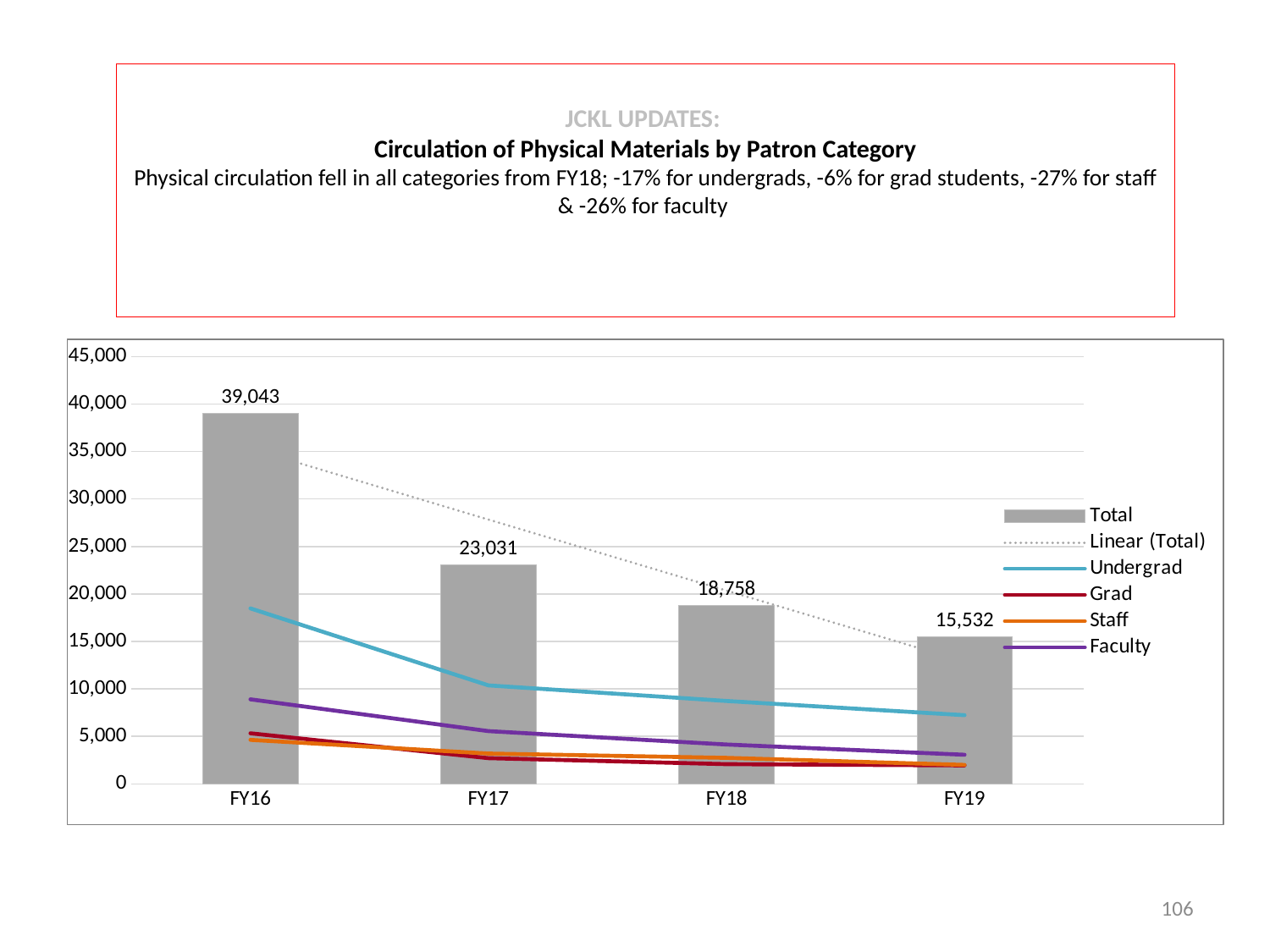
What is the Total circulation value for FY16? 39,043 What is the difference between the Total circulation in FY16 and FY17? 16,012 Which is larger, the Total circulation in FY17 or in FY18? FY17 Which fiscal year has the lowest Total circulation? FY19 Is the Faculty value for FY19 greater or less than 5,000? less Which fiscal year has the highest Total circulation? FY16 How many fiscal years are shown on the x axis? 4 How many entries does the legend list? 6 Does the Total circulation rise or fall from FY16 to FY19? fall What is the Total circulation value for FY19? 15,532 What is the difference between the Total circulation in FY18 and FY19? 3,226 Is the Undergrad value for FY16 greater or less than 15,000? greater